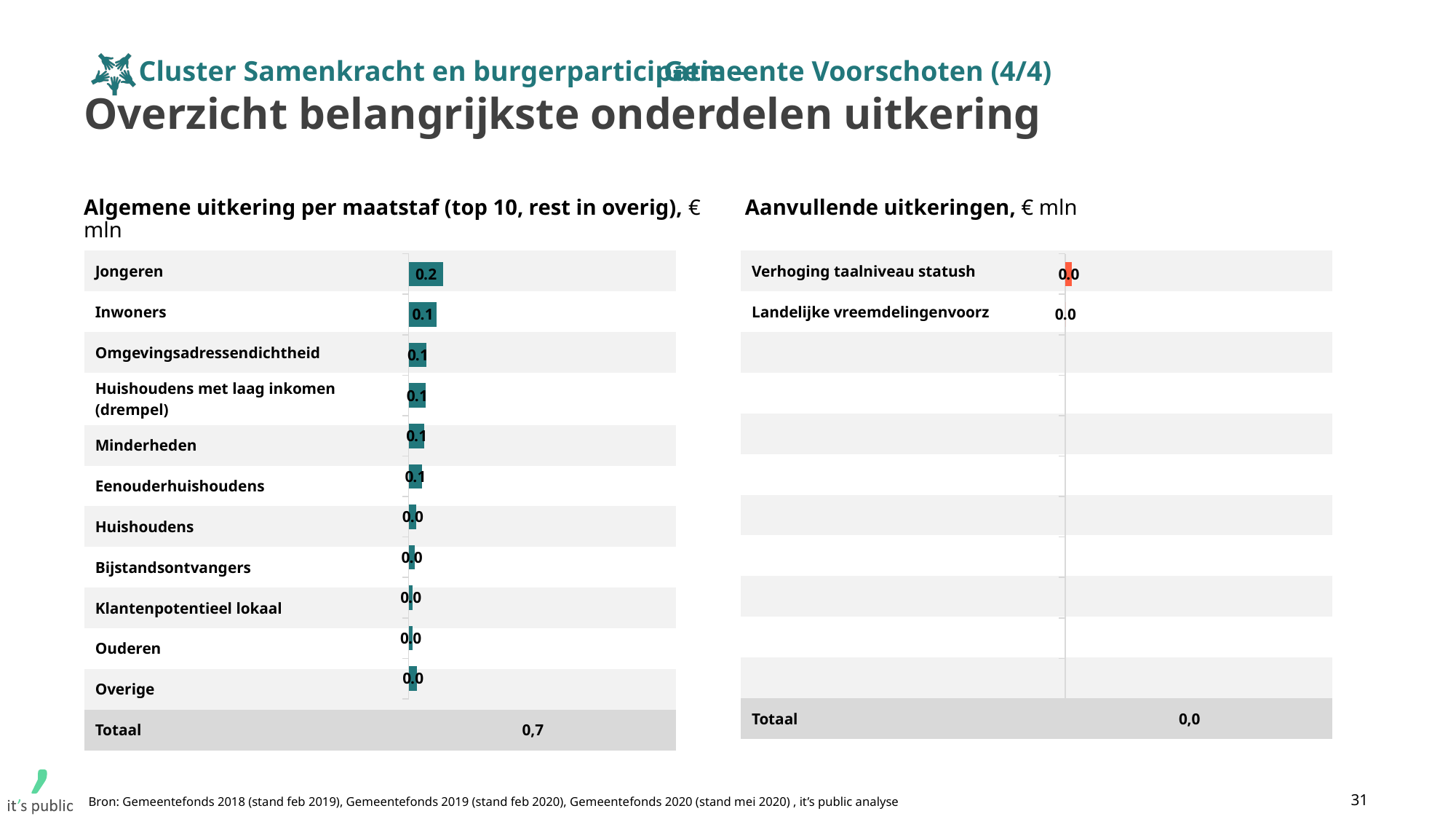
In the 'Aanvullende uitkeringen' chart, what is the value for Verhoging taalniveau statush? 0.0 In the 'Algemene uitkering per maatstaf' chart, what is the value for Ouderen? 0.0 What is the Totaal shown for the 'Algemene uitkering per maatstaf' chart? 0,7 In the 'Algemene uitkering per maatstaf' chart, which category has the highest value? Jongeren In the 'Algemene uitkering per maatstaf' chart, what is the value for Jongeren? 0.2 In the 'Algemene uitkering per maatstaf' chart, what is the value for Inwoners? 0.1 In the 'Algemene uitkering per maatstaf' chart, what is the difference between Jongeren and Inwoners? 0.1 In the 'Algemene uitkering per maatstaf' chart, which is larger: Jongeren or Inwoners? Jongeren How many categories are shown in the 'Aanvullende uitkeringen' chart? 2 What type of chart is used for 'Algemene uitkering per maatstaf'? bar chart How many categories are shown in the 'Algemene uitkering per maatstaf' chart? 11 What is the Totaal shown for the 'Aanvullende uitkeringen' chart? 0,0